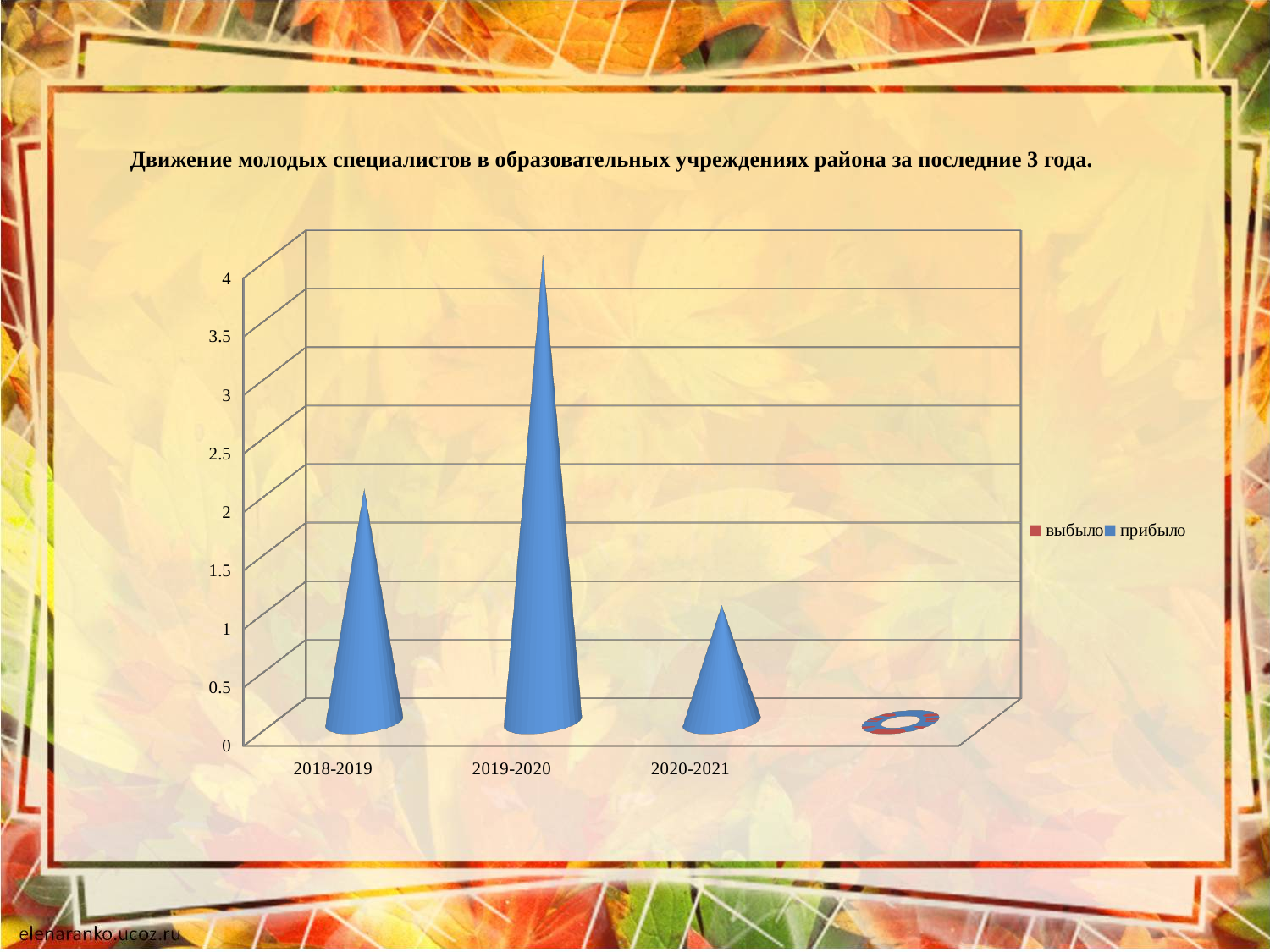
Which school year has the lowest value for прибыло? 2020-2021 Which is larger, the прибыло value for 2018-2019 or for 2020-2021? 2018-2019 What are the two series named in the legend? выбыло and прибыло What kind of chart is shown on the slide? bar chart What colour represents the прибыло series? blue Is the прибыло value for 2020-2021 greater or less than 1.5? less Does the прибыло value rise or fall from 2019-2020 to 2020-2021? fall Which school year has the highest value for прибыло? 2019-2020 How many series does the legend list? 2 How many categories (school years) are shown on the x axis? 3 Is the прибыло value for 2019-2020 greater or less than 3? greater Is the прибыло value for 2018-2019 greater or less than 1.5? greater